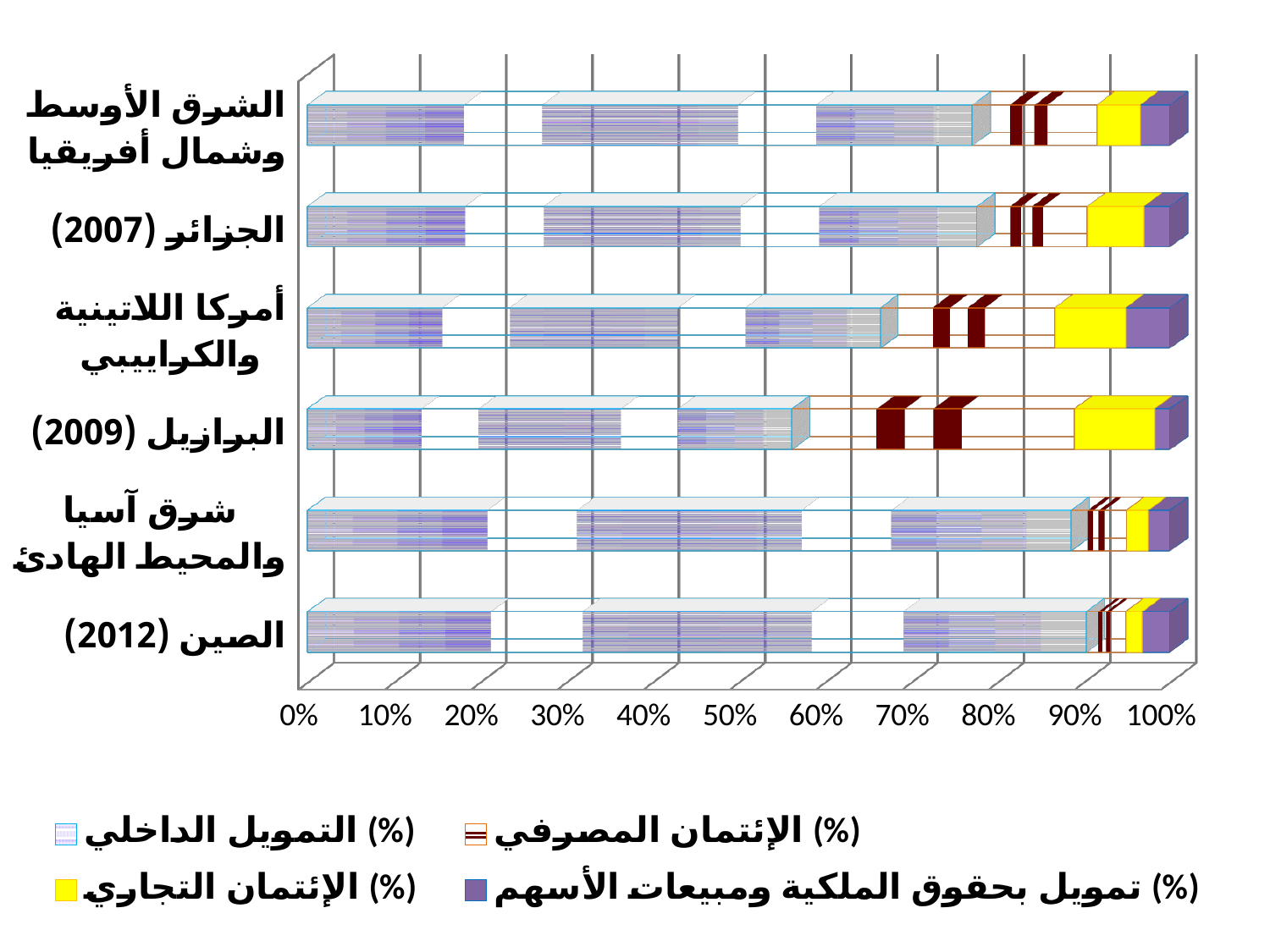
Is the share of التمويل الداخلي (%) for الشرق الأوسط وشمال أفريقيا greater or less than 70%? greater Which category has the smallest share of التمويل الداخلي (%)? البرازيل (2009) What kind of chart is shown on the slide? Stacked bar chart Is the share of التمويل الداخلي (%) for الصين (2012) greater or less than 80%? greater Is the share of التمويل الداخلي (%) for البرازيل (2009) greater or less than 60%? less Which has a larger share of الإئتمان التجاري (%): البرازيل (2009) or شرق آسيا والمحيط الهادئ? البرازيل (2009) What colour represents الإئتمان التجاري (%) in the legend? Yellow How many categories (regions/countries) are shown on the vertical axis? 6 Which has a larger share of الإئتمان المصرفي (%): البرازيل (2009) or الصين (2012)? البرازيل (2009) How many series does the legend list? 4 Which category has the largest share of الإئتمان المصرفي (%)? البرازيل (2009)